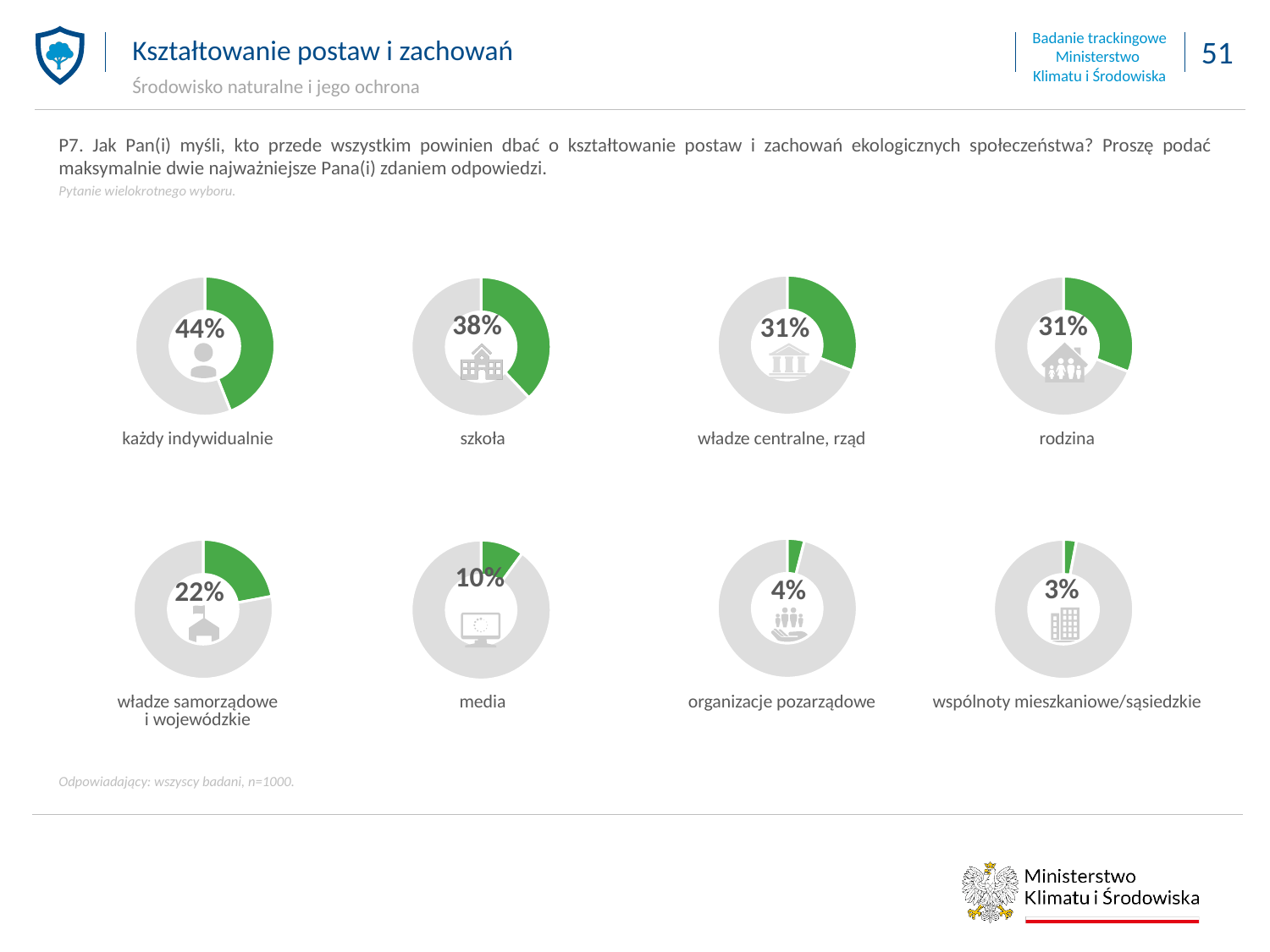
In the donut chart labelled "wspólnoty mieszkaniowe/sąsiedzkie", what percentage is shown? 3% In the donut chart labelled "media", what percentage is shown? 10% What type of chart is used to show each percentage on the slide? donut chart Which two donut charts on the slide show the same value of 31%? władze centralne, rząd and rodzina Which is larger: the value in the "władze samorządowe i wojewódzkie" chart or the value in the "media" chart? władze samorządowe i wojewódzkie In the donut chart labelled "szkoła", what percentage is shown? 38% In the donut chart labelled "każdy indywidualnie", what percentage is shown? 44% What is the difference between the value in the "każdy indywidualnie" chart and the value in the "szkoła" chart? 6% Across all the donut charts on the slide, which category has the lowest value? wspólnoty mieszkaniowe/sąsiedzkie Across all the donut charts on the slide, which category has the highest value? każdy indywidualnie What is the difference between the value in the "organizacje pozarządowe" chart and the value in the "wspólnoty mieszkaniowe/sąsiedzkie" chart? 1% How many donut charts are shown on the slide? 8